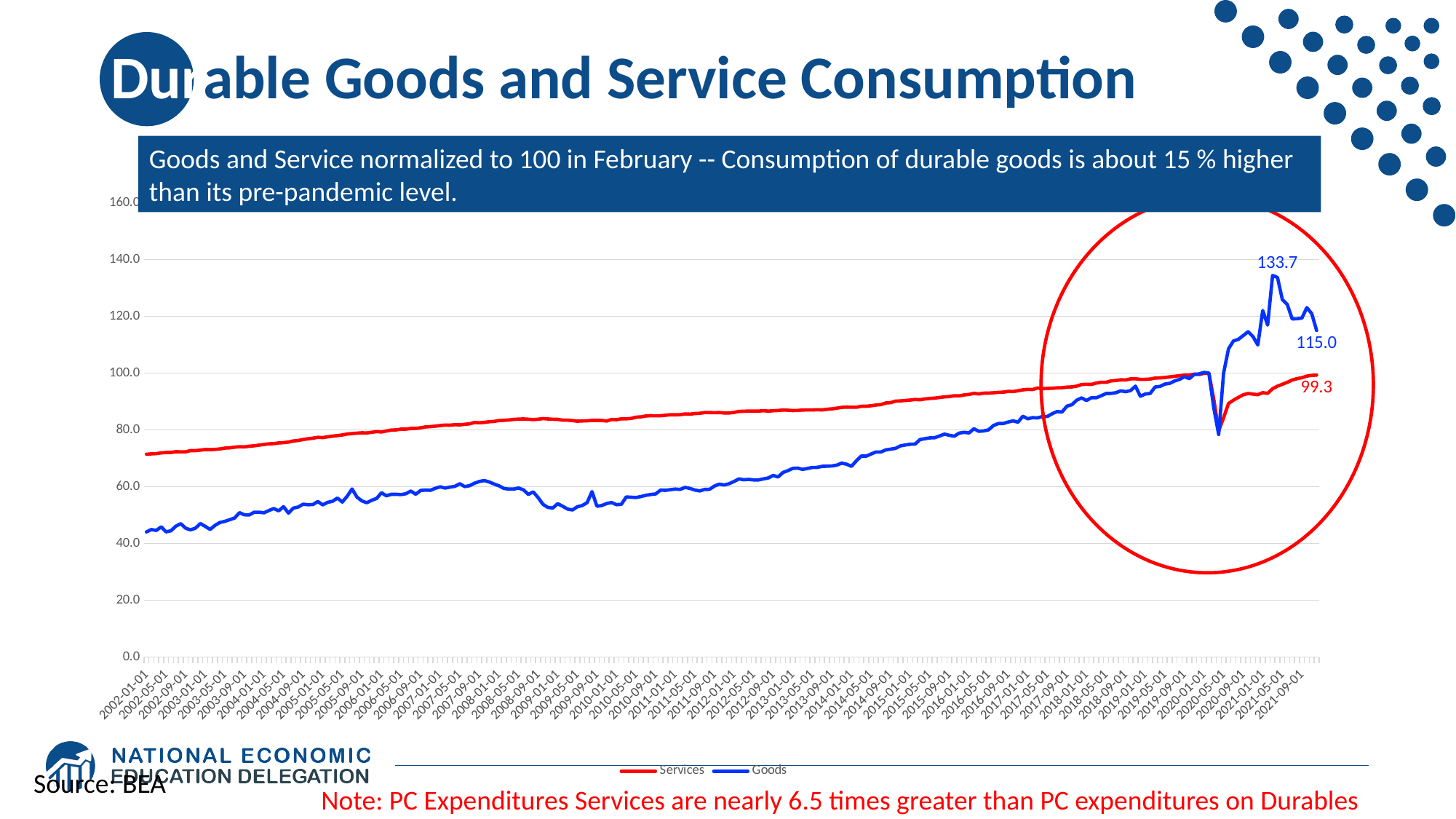
What type of chart is shown on the slide? line chart Which series reaches the highest value on the chart? Goods At the end of the series, which is larger: Goods or Services? Goods Is the value for Goods at 2002-01-01 greater or less than 60? less Is the value for Services at 2002-01-01 greater or less than 80? less What is the difference between the Goods peak of 133.7 and its final labelled value of 115.0? 18.7 What is the difference between the final labelled Goods value and the final labelled Services value? 15.7 What colour is the Goods line? blue How many series does the legend list? 2 What is the last labelled value of the Services series? 99.3 What is the peak value labelled on the Goods series? 133.7 What is the last labelled value of the Goods series? 115.0